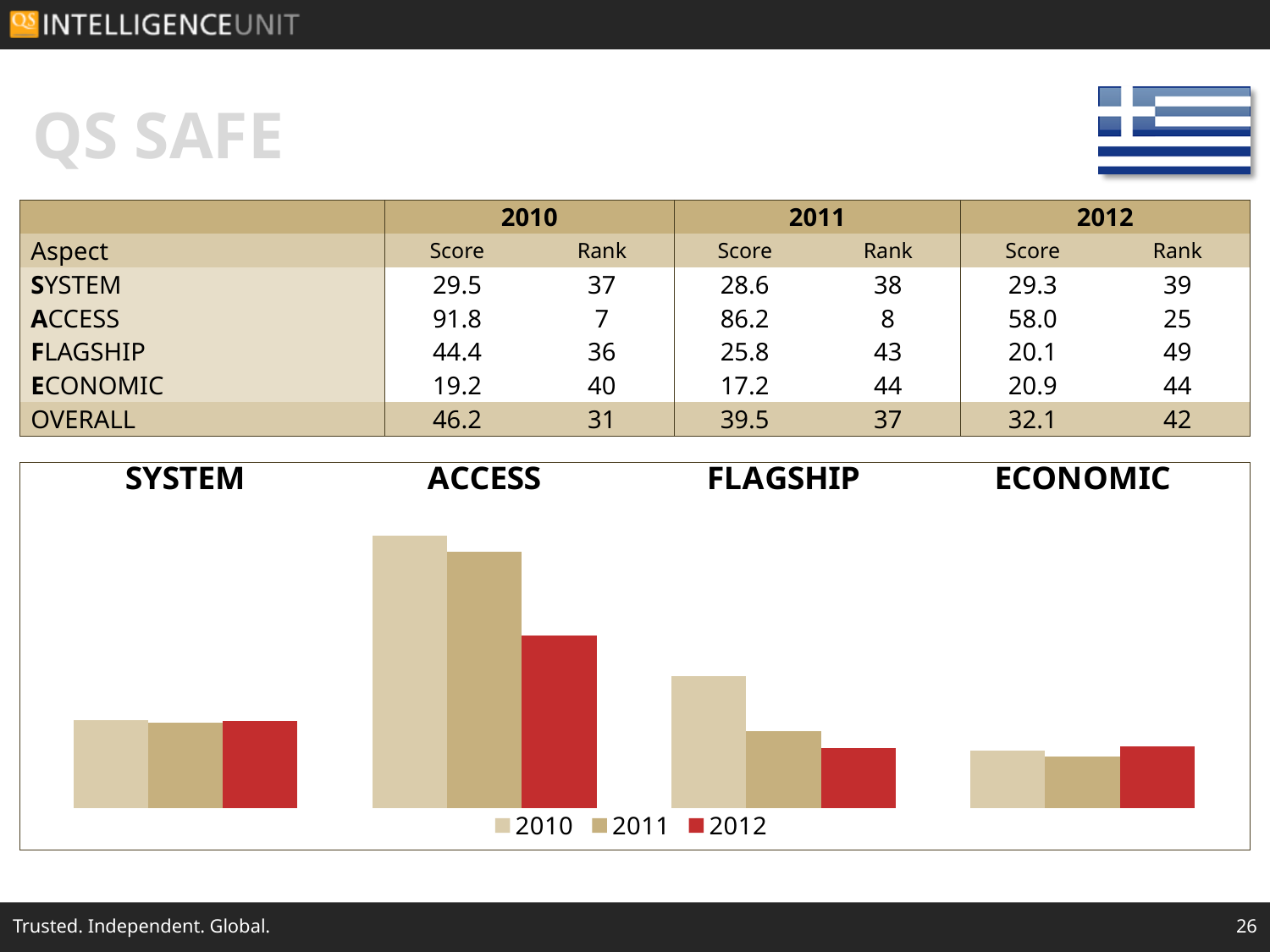
What is the 2011 score for FLAGSHIP plotted in the chart? 25.8 Do the ACCESS bars rise or fall from 2010 to 2012? fall By how much did the ACCESS score fall from 2010 to 2012? 33.8 Which aspect has the highest 2010 bar in the chart? ACCESS Which is larger in the chart: the 2012 bar for ECONOMIC or the 2011 bar for ECONOMIC? 2012 Which is larger in the chart: the 2010 bar for FLAGSHIP or the 2010 bar for SYSTEM? FLAGSHIP How many aspect categories are plotted in the chart? 4 How many series does the chart's legend list? 3 What colour are the 2012 bars in the chart? red What is the 2012 score for ACCESS plotted in the chart? 58.0 Which aspect has the lowest 2010 bar in the chart? ECONOMIC What kind of chart is shown below the table? bar chart